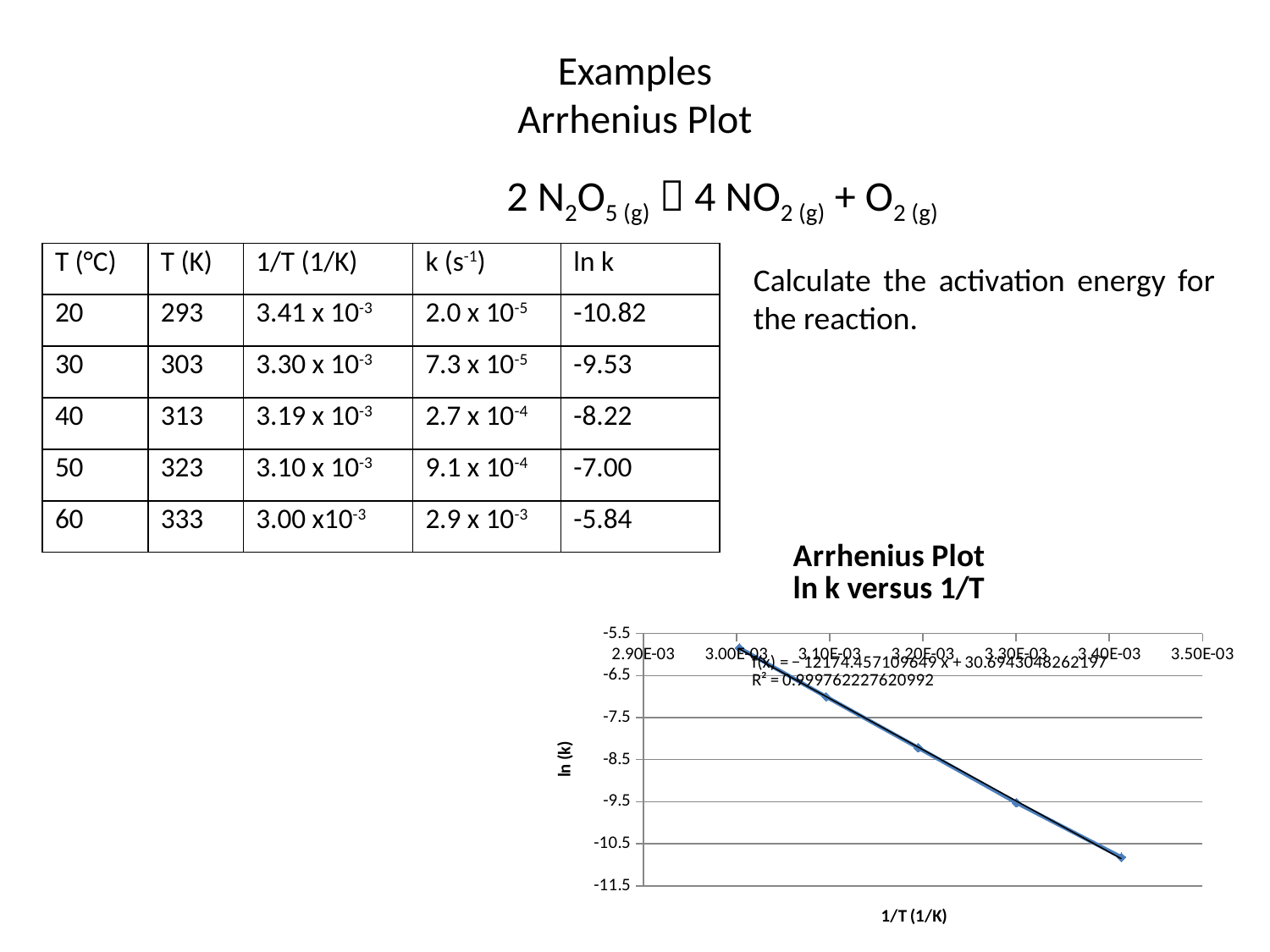
How many data points are plotted on the Arrhenius Plot chart? 5 On the Arrhenius Plot chart, is the ln (k) value of the rightmost point (near 3.40E-03) greater or less than -10.5? less On the Arrhenius Plot chart, which point has the highest ln (k) value: the one near 3.00E-03 or the one near 3.40E-03? The one near 3.00E-03 On the Arrhenius Plot chart, which point has the lowest ln (k) value? The rightmost point, near 3.40E-03 On the Arrhenius Plot chart, is the ln (k) value of the point near 3.20E-03 greater or less than -8.5? greater What is the title of the y axis on the Arrhenius Plot chart? ln (k) On the Arrhenius Plot chart, is the ln (k) value of the leftmost point (near 3.00E-03) greater or less than -6.5? greater What is the title of the x axis on the Arrhenius Plot chart? 1/T (1/K) On the Arrhenius Plot chart, does ln (k) rise or fall as 1/T increases along the x axis? Fall What kind of chart is the "Arrhenius Plot ln k versus 1/T" chart? Scatter plot with a trendline